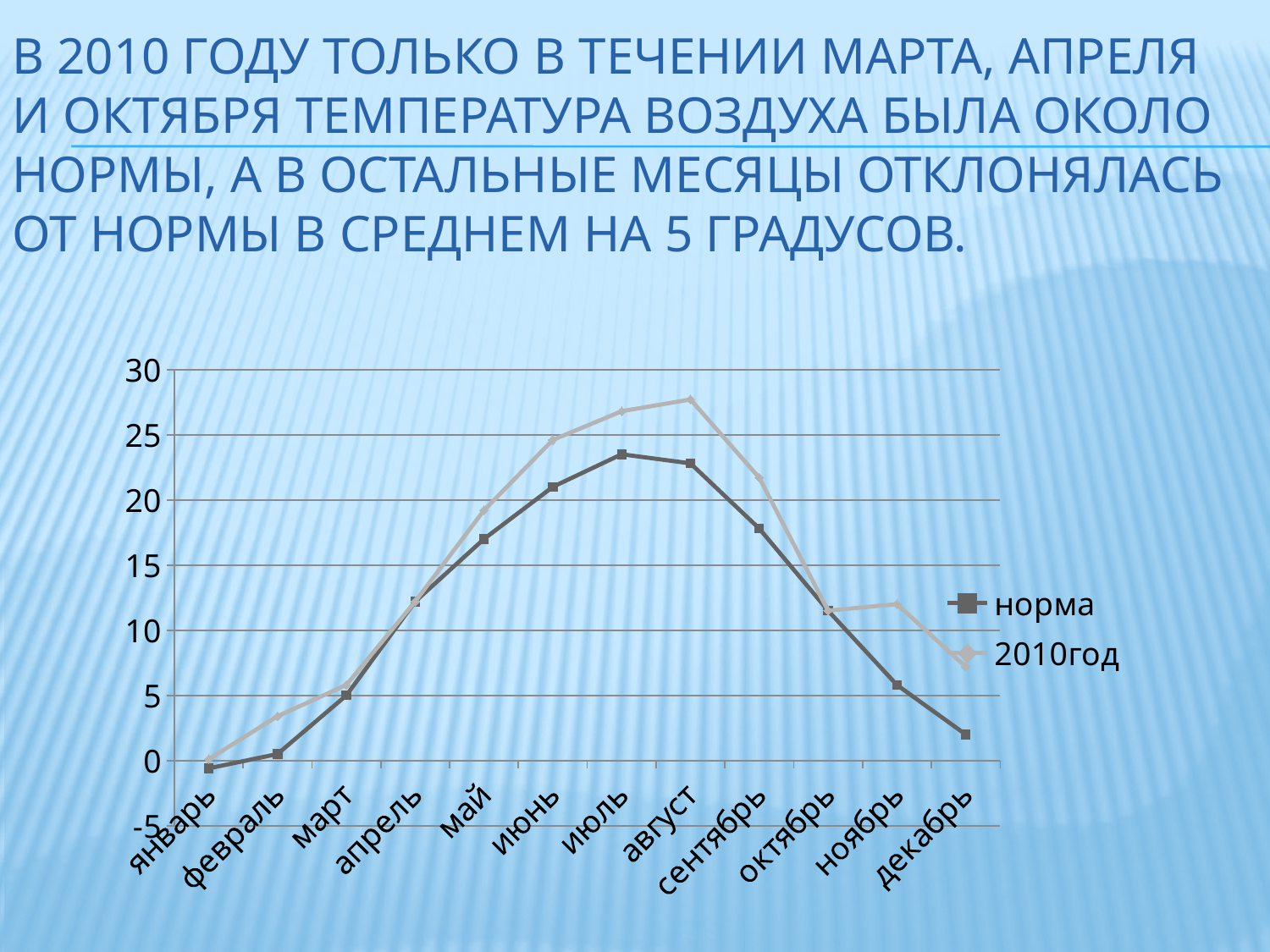
In which month is the норма series at its lowest value? январь Does the норма series rise or fall from январь to июль? rise Is the value of 2010год in август greater or less than 25? greater How many series does the legend list? 2 In which month does the 2010год series reach its highest value? август What kind of chart is shown on the slide? line chart In which month does the норма series reach its highest value? июль Is the value of 2010год in ноябрь greater or less than 10? greater In июль, which series has the higher value, норма or 2010год? 2010год Is the value of норма in декабрь greater or less than 5? less How many months are plotted along the x axis? 12